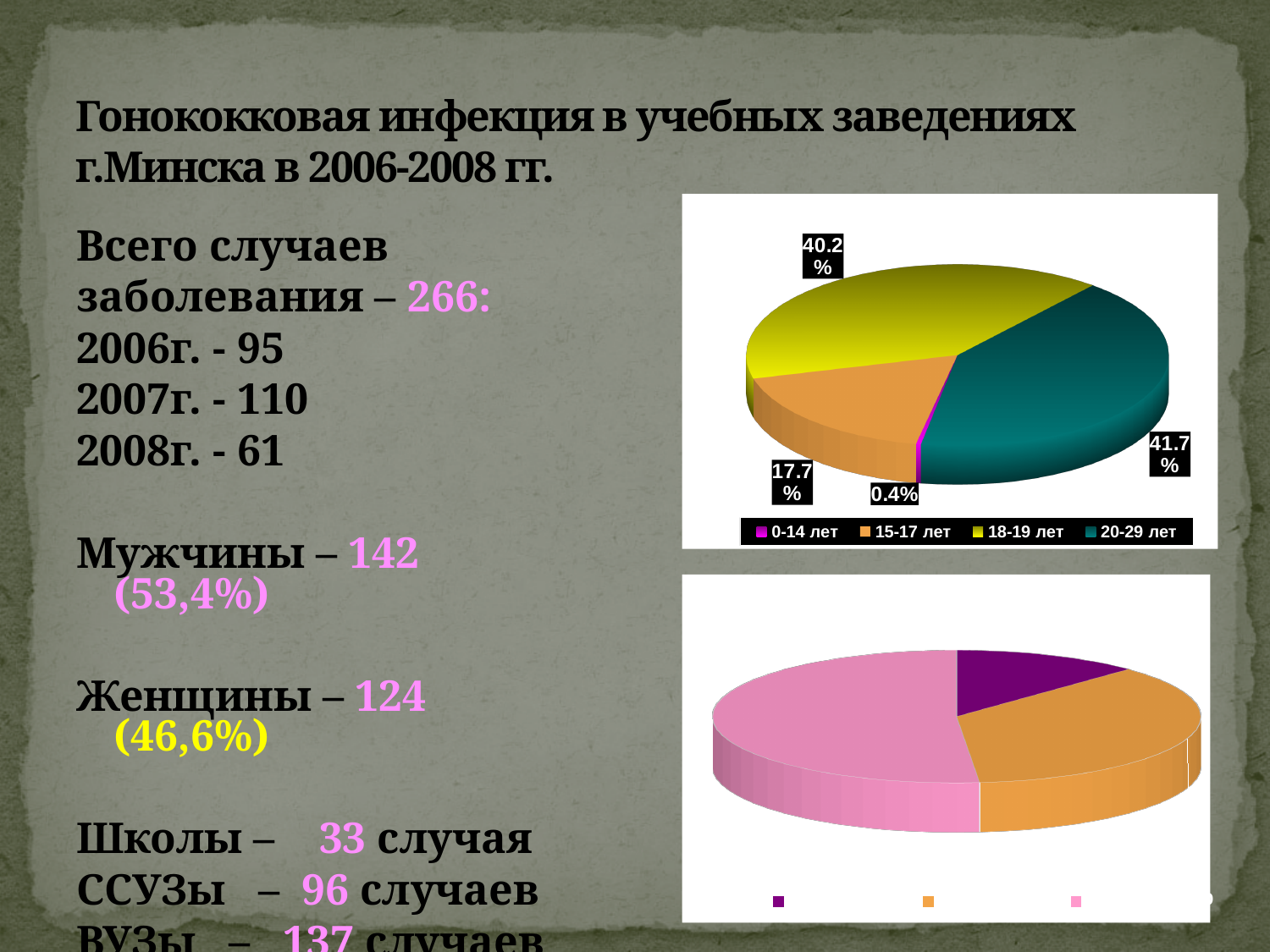
How many entries does the legend of the top pie chart list? 4 In the top pie chart, what share is shown for the 18-19 лет group? 40.2% What kind of chart is the top chart on the slide? pie chart In the top pie chart, which age group has the smallest share? 0-14 лет In the top pie chart, which age group has the largest share? 20-29 лет In the top pie chart, which group has the larger share: 18-19 лет or 15-17 лет? 18-19 лет In the top pie chart, what share is shown for the 20-29 лет group? 41.7% In the top pie chart, what is the difference between the shares of the 20-29 лет and 15-17 лет groups? 24.0% In the top pie chart, what share is shown for the 15-17 лет group? 17.7% In the top pie chart, what share is shown for the 0-14 лет group? 0.4% How many age groups are shown in the top pie chart? 4 How many slices does the bottom pie chart have? 3